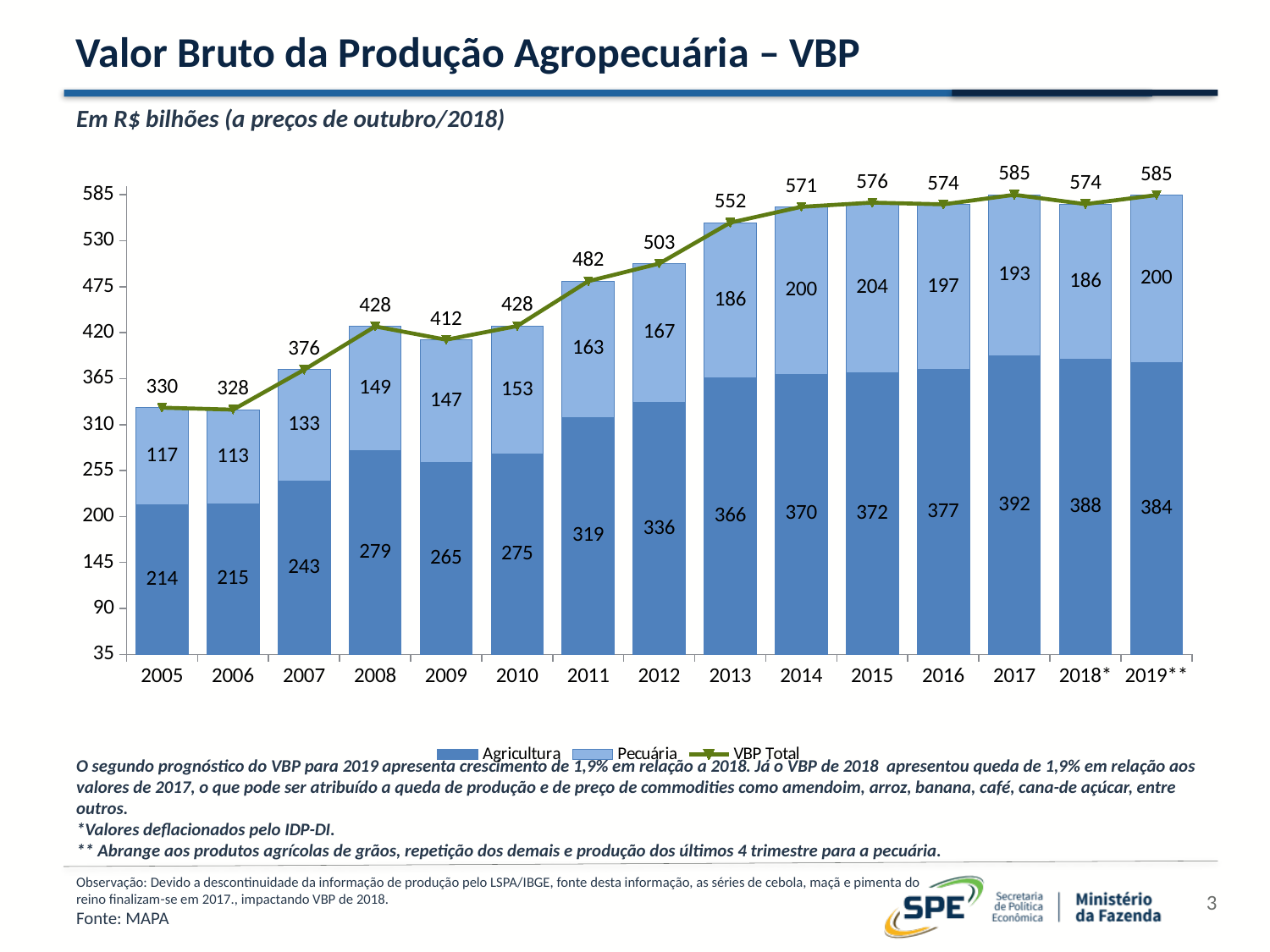
What is the Pecuária value for 2015? 204 What is the VBP Total value for 2013? 552 Which year has the highest Agricultura value? 2017 Which year has the lowest VBP Total value? 2006 What kind of chart is shown on the slide? Stacked bar chart with a line Which is larger, the Pecuária value for 2016 or for 2019**? 2019** Does the VBP Total line generally rise or fall from 2005 to 2017? Rise What is the difference between the Agricultura values for 2017 and 2005? 178 What is the Agricultura value for 2011? 319 Which year has the lowest Pecuária value? 2006 How many series does the legend list? 3 How many years are shown on the x axis? 15